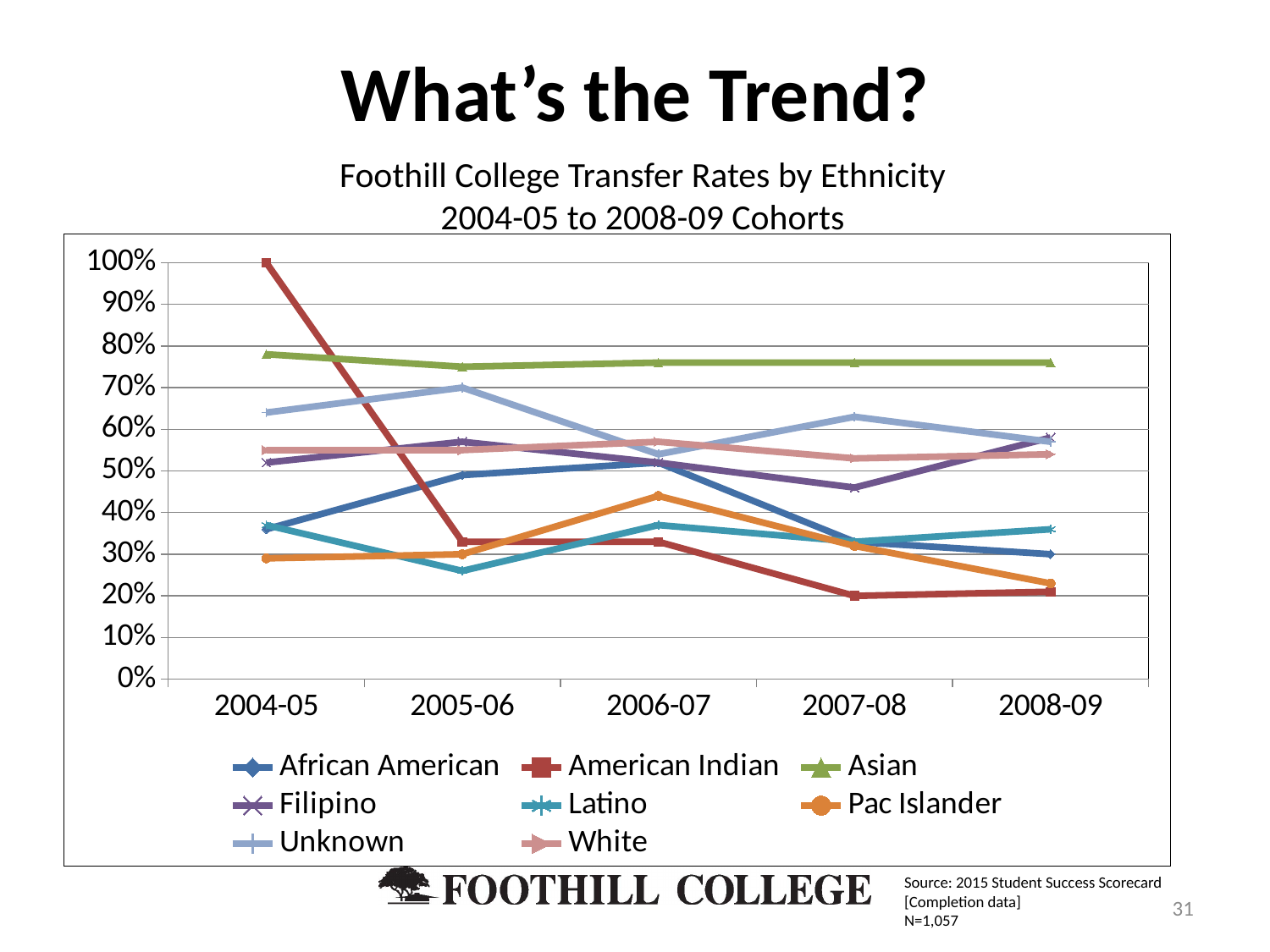
Is the transfer rate for African American students in the 2008-09 cohort greater or less than 40%? less Which ethnicity has the highest transfer rate in the 2008-09 cohort? Asian How many cohorts are shown along the x axis? 5 What kind of chart is shown on the slide? line chart How many series does the legend list? 8 Which ethnicity has the lowest transfer rate in the 2004-05 cohort? Pac Islander Does the transfer rate for American Indian students rise or fall from the 2004-05 cohort to the 2008-09 cohort? fall Is the transfer rate for Asian students in the 2004-05 cohort greater or less than 70%? greater What is the transfer rate for American Indian students in the 2004-05 cohort? 100% What is the title of the chart? Foothill College Transfer Rates by Ethnicity 2004-05 to 2008-09 Cohorts Which ethnicity has the highest transfer rate in the 2004-05 cohort? American Indian Which ethnicity has the lowest transfer rate in the 2007-08 cohort? American Indian